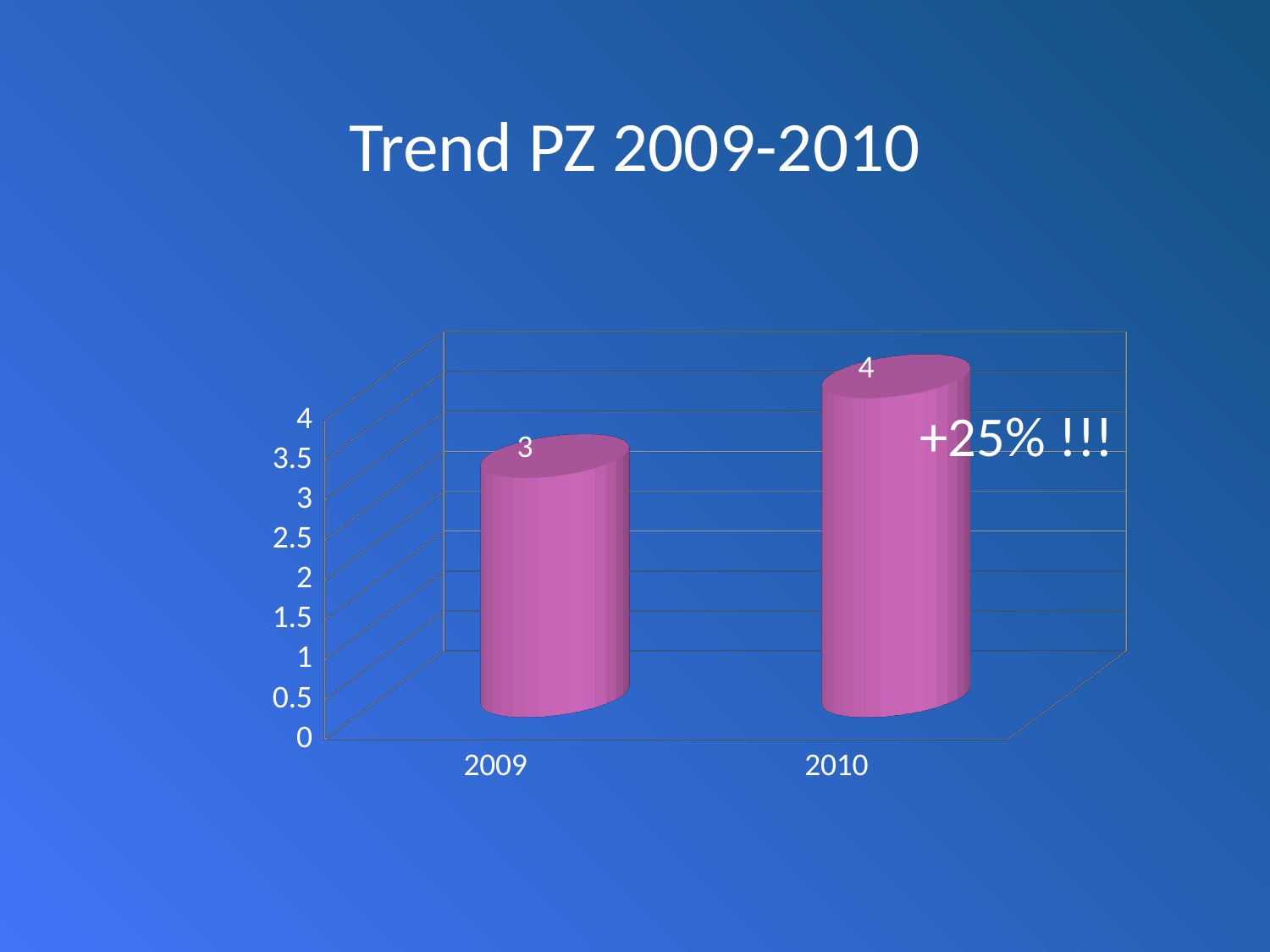
Is the value for 2009 greater or less than 3.5? less How many categories are shown on the x axis? 2 Is the value for 2010 greater or less than 3.5? greater What is the value for 2009? 3 What is the difference between the values for 2010 and 2009? 1 Do the values rise or fall from 2009 to 2010? rise Which year has the highest value? 2010 What kind of chart is shown on the slide? bar chart What is the value for 2010? 4 What is the title of the slide? Trend PZ 2009-2010 Which year has the lowest value? 2009 Which is larger, the value for 2009 or the value for 2010? 2010